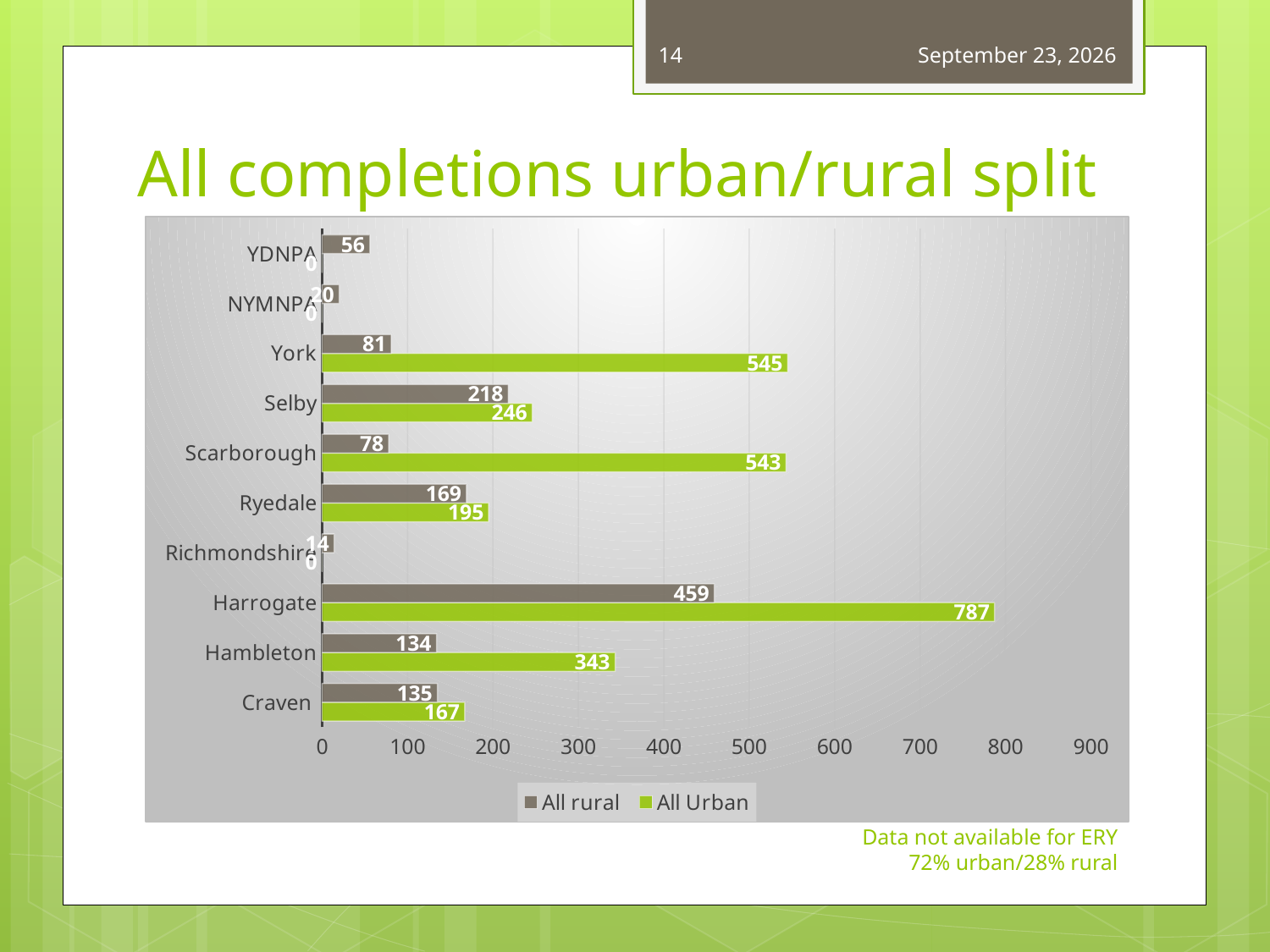
What is the All Urban value for Harrogate? 787 What is the All Urban value for Hambleton? 343 How many categories are shown on the chart? 10 What kind of chart is shown on the slide? bar chart Which category has the highest All rural value? Harrogate What is the difference between the All Urban and All rural values for Craven? 32 What is the All rural value for York? 81 How many series does the legend list? 2 Which category has the highest All Urban value? Harrogate Is the All Urban value for Scarborough greater or less than 500? greater For Selby, which is larger: All rural or All Urban? All Urban What is the difference between the All Urban and All rural values for Harrogate? 328